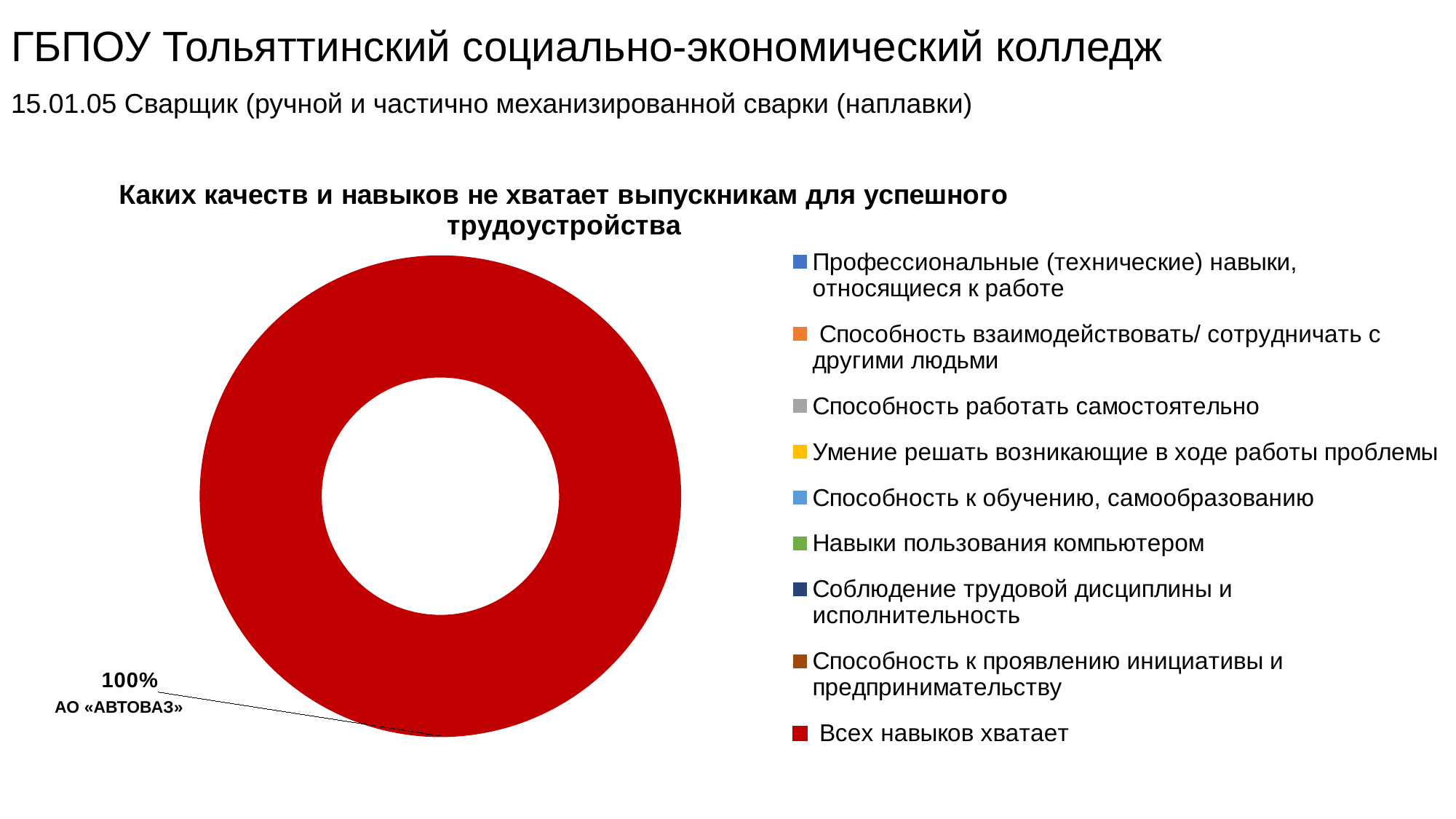
How many categories are listed in the chart legend? 9 What share of the chart does the category "Всех навыков хватает" take? 100% Which legend entry is listed last? Всех навыков хватает Which organisation is named next to the 100% data label? АО «АВТОВАЗ» Which is larger: the share for "Всех навыков хватает" or the share for "Навыки пользования компьютером"? Всех навыков хватает Which category accounts for the largest share of the chart? Всех навыков хватает Is the share for "Всех навыков хватает" greater or less than 50%? greater What kind of chart is shown on the slide? Doughnut (pie) chart What is the title of the chart? Каких качеств и навыков не хватает выпускникам для успешного трудоустройства What value is printed as the data label on the chart? 100%